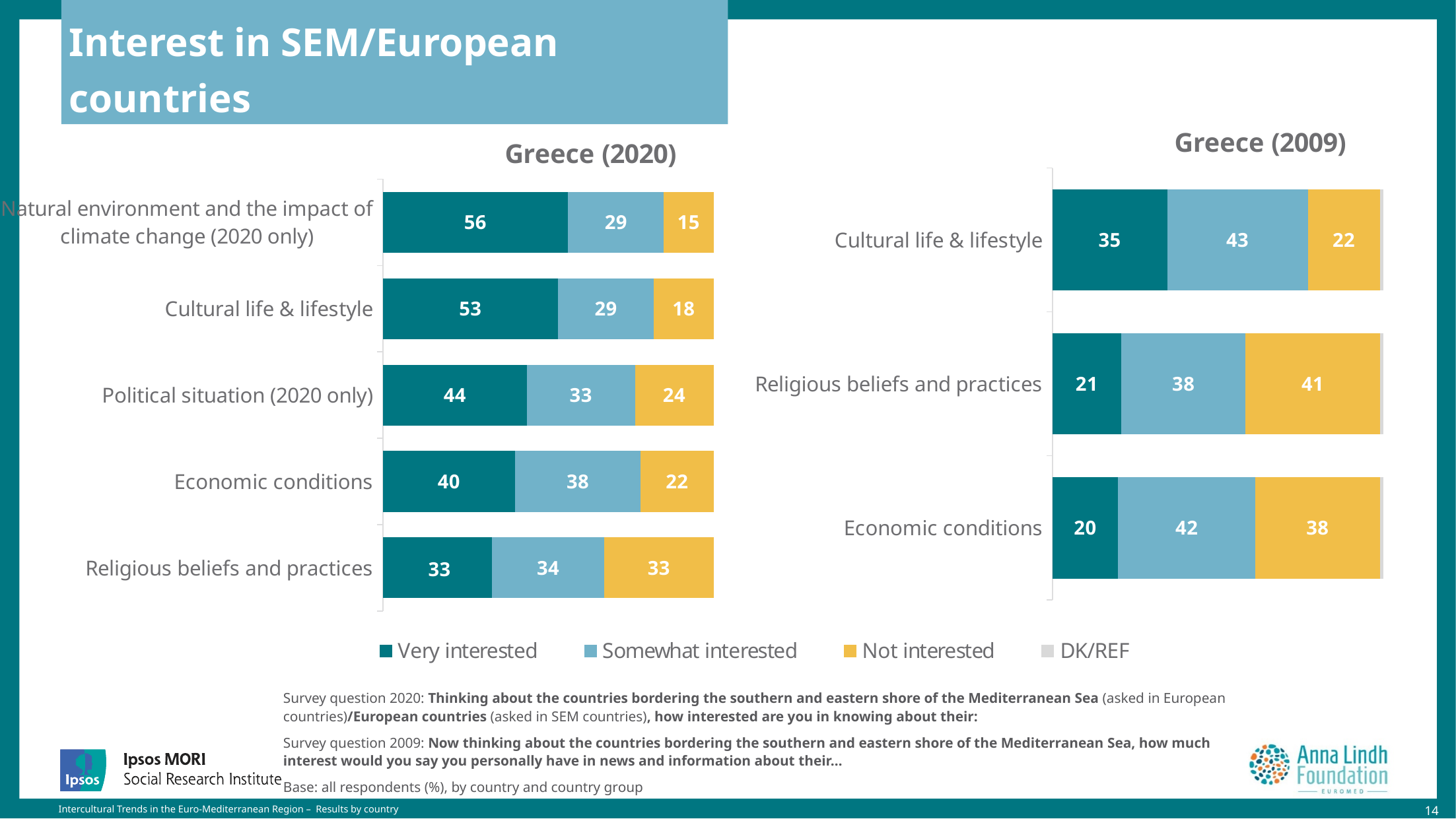
In the Greece (2020) chart, which category has the highest 'Very interested' value? Natural environment and the impact of climate change (2020 only) In the Greece (2020) chart, what is the total of the Religious beliefs and practices bar? 100 How many categories are shown in the Greece (2020) chart? 5 In the Greece (2009) chart, which category has the lowest 'Very interested' value? Economic conditions What kind of chart is the Greece (2020) chart? Stacked bar chart In the Greece (2020) chart, what percentage is 'Very interested' in Cultural life & lifestyle? 53 In the Greece (2009) chart, what percentage is 'Not interested' in Religious beliefs and practices? 41 Which is larger: the 'Very interested' value for Cultural life & lifestyle in the Greece (2020) chart or in the Greece (2009) chart? Greece (2020) In the Greece (2009) chart, what is the 'Somewhat interested' value for Economic conditions? 42 How many series does the legend list? 4 How many categories are shown in the Greece (2009) chart? 3 In the Greece (2020) chart, what is the difference between the 'Very interested' values for Political situation (2020 only) and Economic conditions? 4